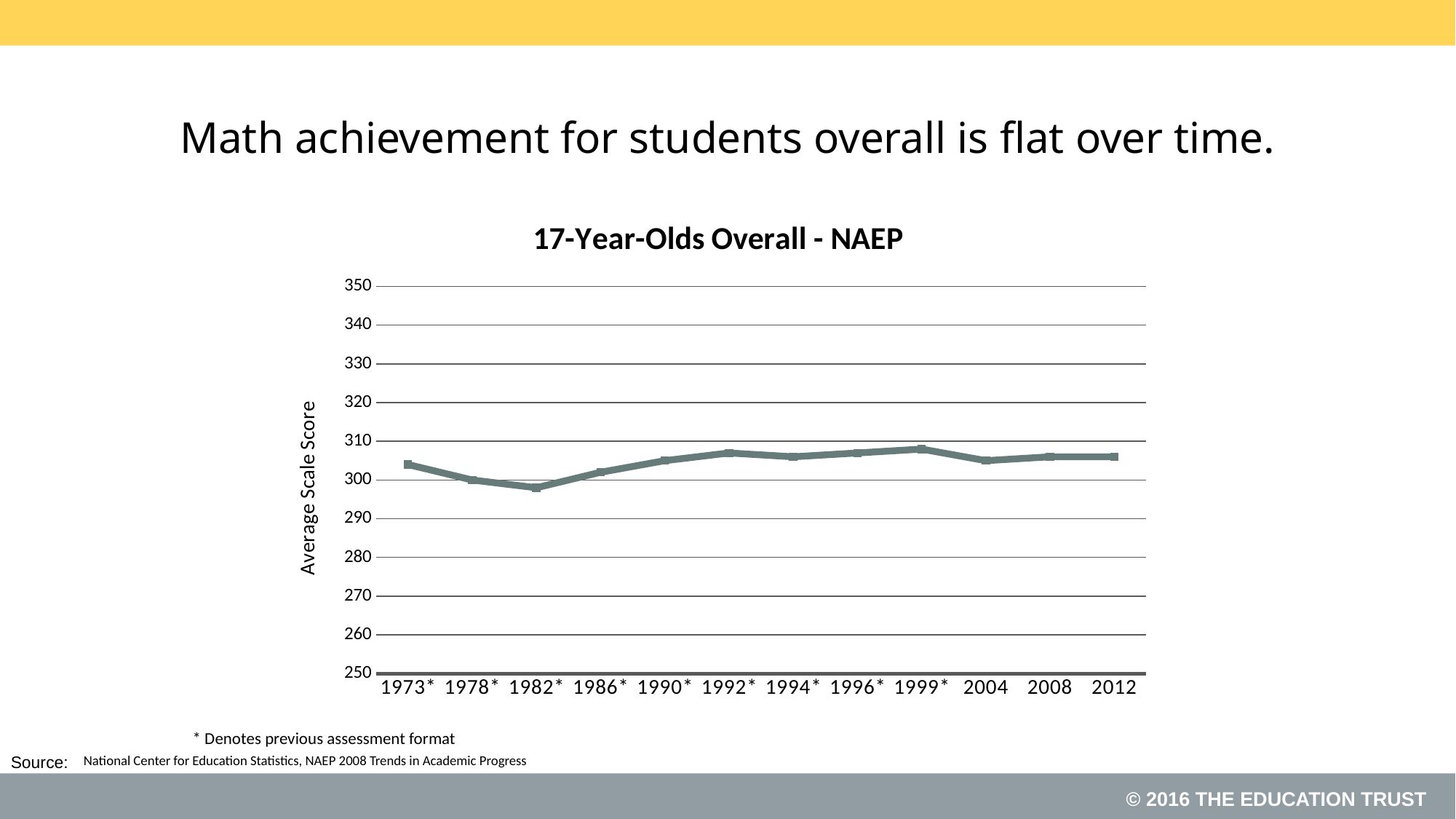
Which is larger, the value for 1982* or the value for 1992*? 1992* What is the label on the vertical axis of the chart? Average Scale Score What kind of chart is shown on the slide? line chart Is the value for 1999* greater or less than 310? less Is the value for 1982* greater or less than 300? less How many years are plotted along the x axis of the chart? 12 Which year has the lowest average scale score in the chart? 1982* Which is larger, the value for 1973* or the value for 1982*? 1973* Is the value for 1973* greater or less than 300? greater Do the values rise or fall from 1973* to 1982*? fall What is the title of the chart? 17-Year-Olds Overall - NAEP